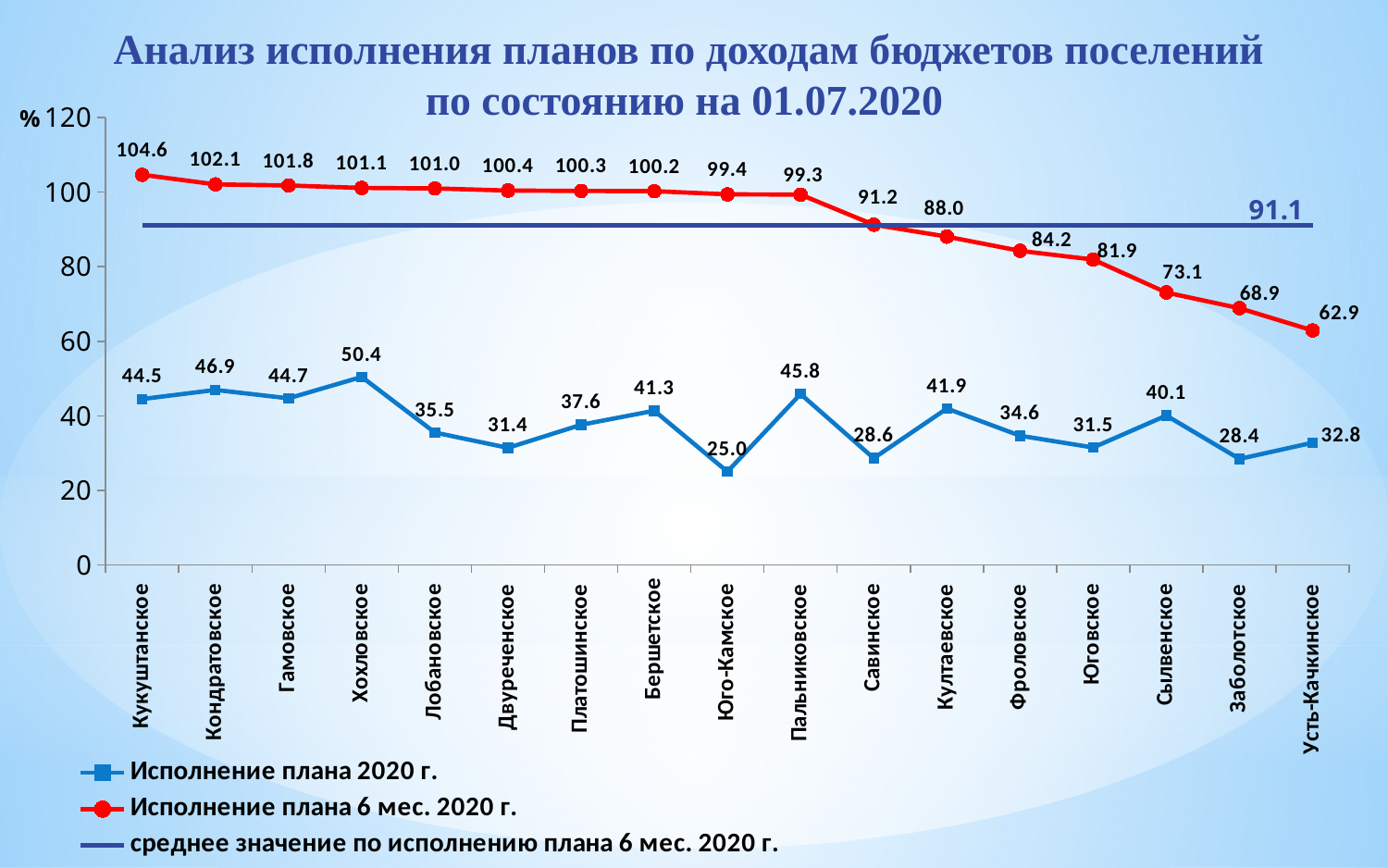
How many settlements are shown on the x axis? 17 What is the value of «Исполнение плана 6 мес. 2020 г.» for Хохловское? 101.1 How many series does the legend list? 3 What is the value of the line «среднее значение по исполнению плана 6 мес. 2020 г.»? 91.1 What kind of chart is shown on the slide? Line chart Does the «Исполнение плана 6 мес. 2020 г.» series rise or fall from left to right along the x axis? Fall For «Исполнение плана 2020 г.», which is larger: Кондратовское or Пальниковское? Кондратовское Which settlement has the highest value for «Исполнение плана 2020 г.»? Хохловское What is the difference between «Исполнение плана 6 мес. 2020 г.» and «Исполнение плана 2020 г.» for Савинское? 62.6 Which settlement has the lowest value for «Исполнение плана 6 мес. 2020 г.»? Усть-Качкинское Which settlement has the lowest value for «Исполнение плана 2020 г.»? Юго-Камское What is the value of «Исполнение плана 2020 г.» for Юго-Камское? 25.0